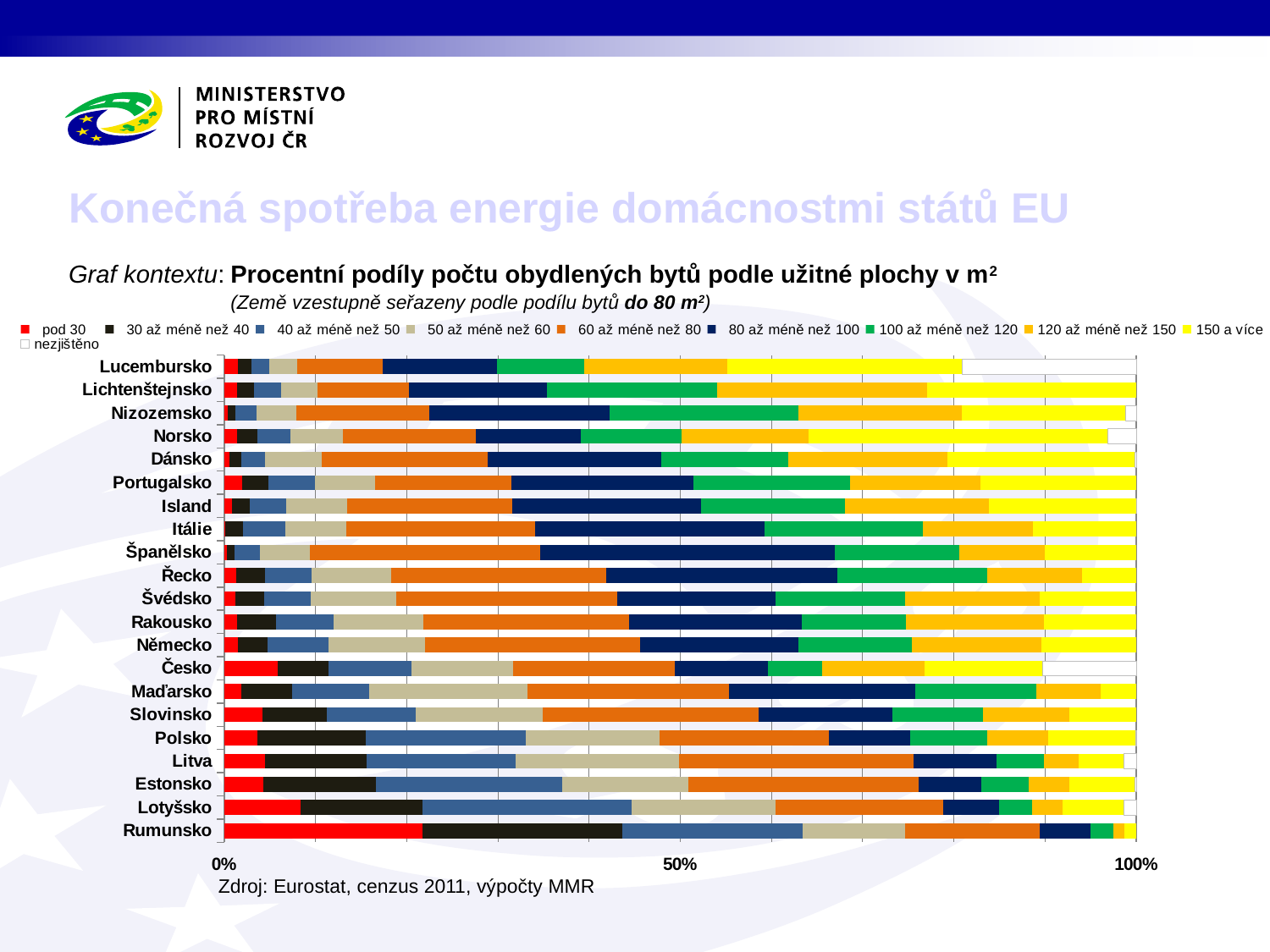
What source is cited below the chart? Eurostat, cenzus 2011, výpočty MMR Which country has the smallest share of dwellings in the '150 a více' category? Rumunsko Going down the chart from Lucembursko to Rumunsko, does the share of dwellings up to 80 m² rise or fall? rise Is the combined share of dwellings up to 80 m² (categories through '60 až méně než 80') for Lucembursko greater or less than 50%? less Which country has a larger share in the 'pod 30' category, Rumunsko or Lotyšsko? Rumunsko Which country is listed at the bottom of the chart? Rumunsko Which country is listed at the top of the chart? Lucembursko How many countries are listed on the vertical axis of the chart? 21 What kind of chart is shown on the slide? Stacked bar chart How many series does the chart legend list? 10 Is the combined share of dwellings up to 80 m² (categories through '60 až méně než 80') for Rumunsko greater or less than 50%? greater Which country has the largest share of dwellings in the '150 a více' category? Norsko